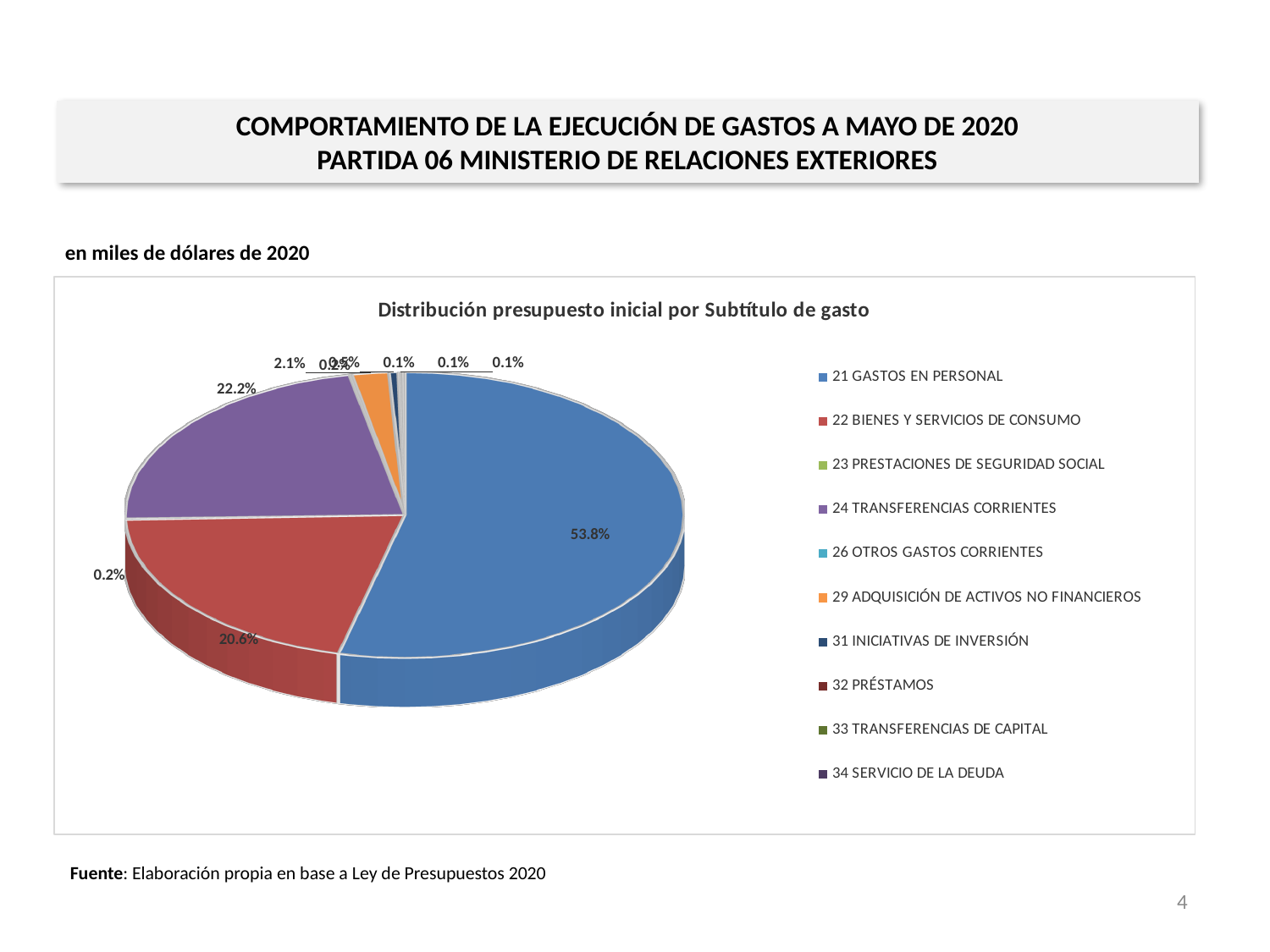
Which category has the largest slice of the pie? 21 GASTOS EN PERSONAL What kind of chart is shown on the slide? pie chart What is the combined share of 21 GASTOS EN PERSONAL and 22 BIENES Y SERVICIOS DE CONSUMO? 74.4% How many categories does the legend list? 10 What share of the pie does 21 GASTOS EN PERSONAL represent? 53.8% What is the difference in percentage points between 24 TRANSFERENCIAS CORRIENTES and 22 BIENES Y SERVICIOS DE CONSUMO? 1.6 What is the difference in percentage points between 21 GASTOS EN PERSONAL and 22 BIENES Y SERVICIOS DE CONSUMO? 33.2 What is the value shown for 24 TRANSFERENCIAS CORRIENTES? 22.2% What is the value shown for 22 BIENES Y SERVICIOS DE CONSUMO? 20.6% What is the title of the chart? Distribución presupuesto inicial por Subtítulo de gasto Which is larger, the slice for 22 BIENES Y SERVICIOS DE CONSUMO or the slice for 24 TRANSFERENCIAS CORRIENTES? 24 TRANSFERENCIAS CORRIENTES What colour is the slice for 21 GASTOS EN PERSONAL? blue